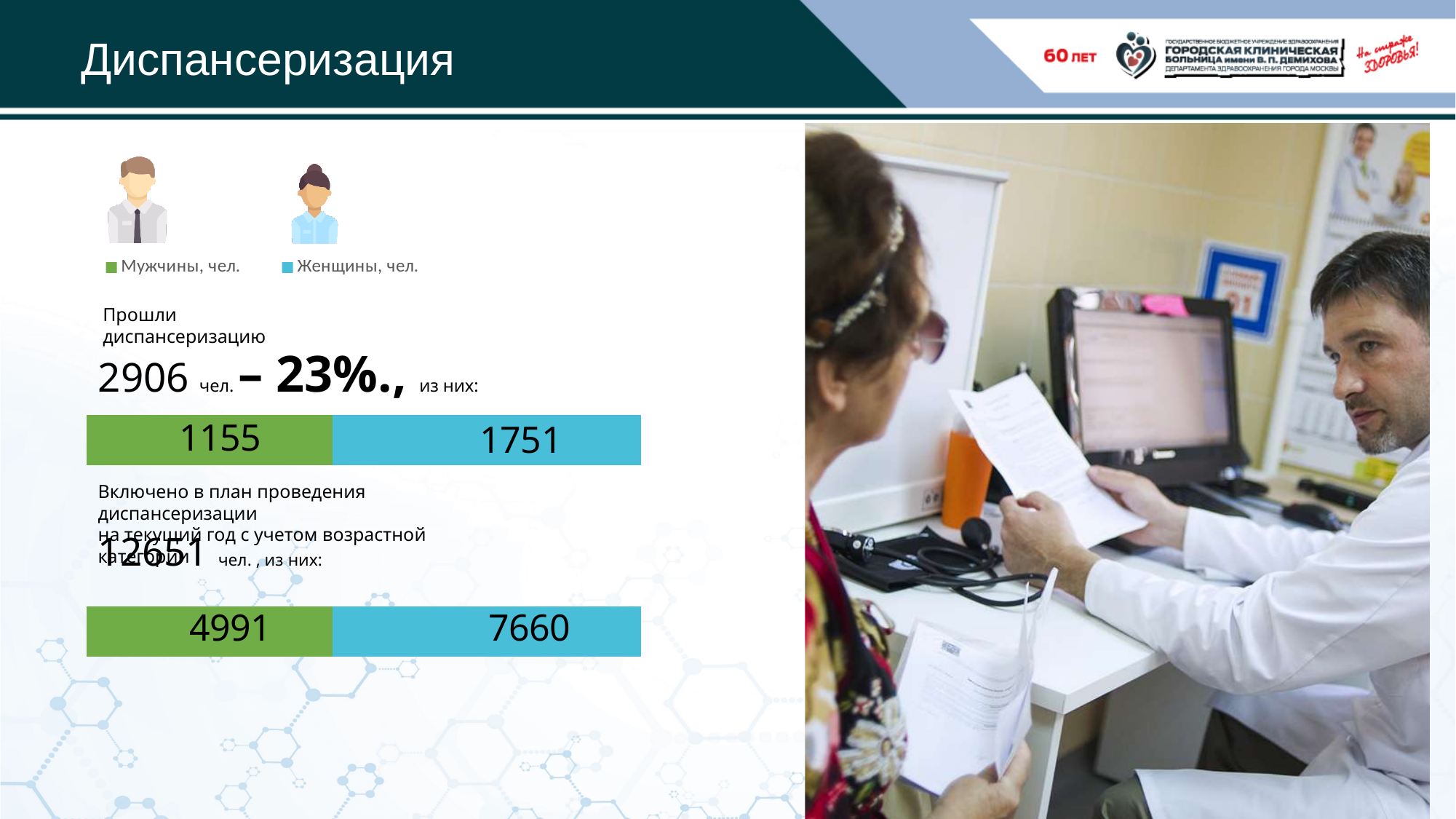
In the upper bar (Прошли диспансеризацию), what is the value for Мужчины, чел.? 1155 In the lower bar (Включено в план проведения диспансеризации), what is the difference between the Женщины and Мужчины values? 2669 In the lower bar (Включено в план проведения диспансеризации), which series has the smaller value, Мужчины or Женщины? Мужчины In the upper bar (Прошли диспансеризацию), which series has the larger value, Мужчины or Женщины? Женщины What colour represents Мужчины, чел. in the legend? Green In the lower bar (Включено в план проведения диспансеризации), what is the value for Мужчины, чел.? 4991 In the upper bar (Прошли диспансеризацию), what is the difference between the Женщины and Мужчины values? 596 In the lower bar (Включено в план проведения диспансеризации), what is the value for Женщины, чел.? 7660 What is the total of the lower stacked bar (Включено в план проведения диспансеризации)? 12651 How many series does the legend list? 2 In the upper bar (Прошли диспансеризацию), what is the value for Женщины, чел.? 1751 What is the total of the upper stacked bar (Прошли диспансеризацию)? 2906